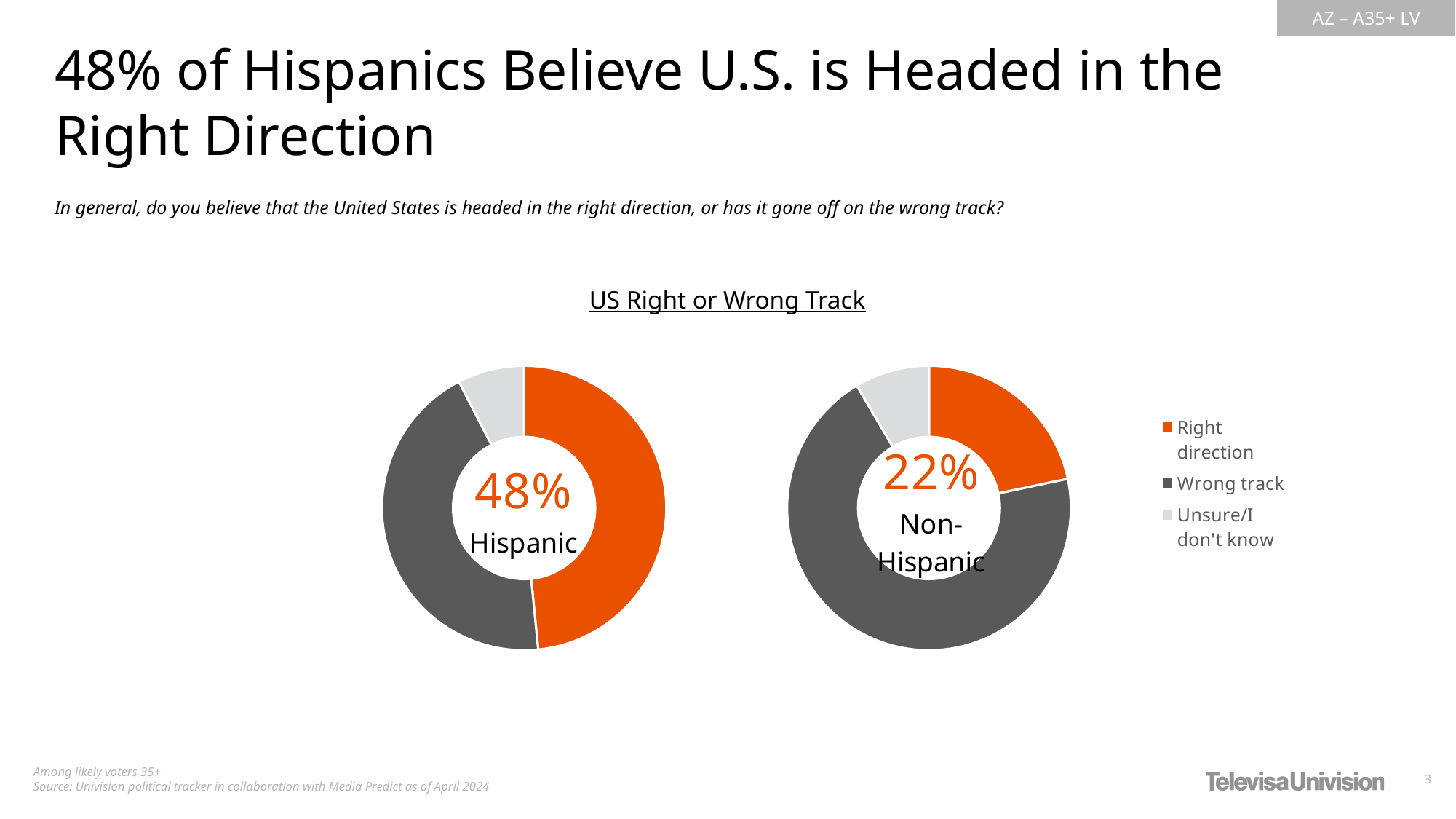
In the Non-Hispanic donut chart, which response makes up the smallest slice? Unsure/I don't know How many categories does the legend list for the US Right or Wrong Track charts? 3 In the Non-Hispanic donut chart, what percentage believe the U.S. is headed in the right direction? 22% How many donut charts are shown on the slide? 2 What is the difference in percentage points between the Hispanic and Non-Hispanic 'Right direction' shares? 26 percentage points Which colour represents 'Right direction' in the donut charts? Orange Which group has the larger share saying 'Right direction', Hispanic or Non-Hispanic? Hispanic In the Hispanic donut chart, which response makes up the smallest slice? Unsure/I don't know In the Non-Hispanic donut chart, which response makes up the largest slice? Wrong track What kind of chart is used to show the US Right or Wrong Track results? Pie (donut) chart What is the title shown above the two donut charts? US Right or Wrong Track In the Hispanic donut chart, what percentage believe the U.S. is headed in the right direction? 48%